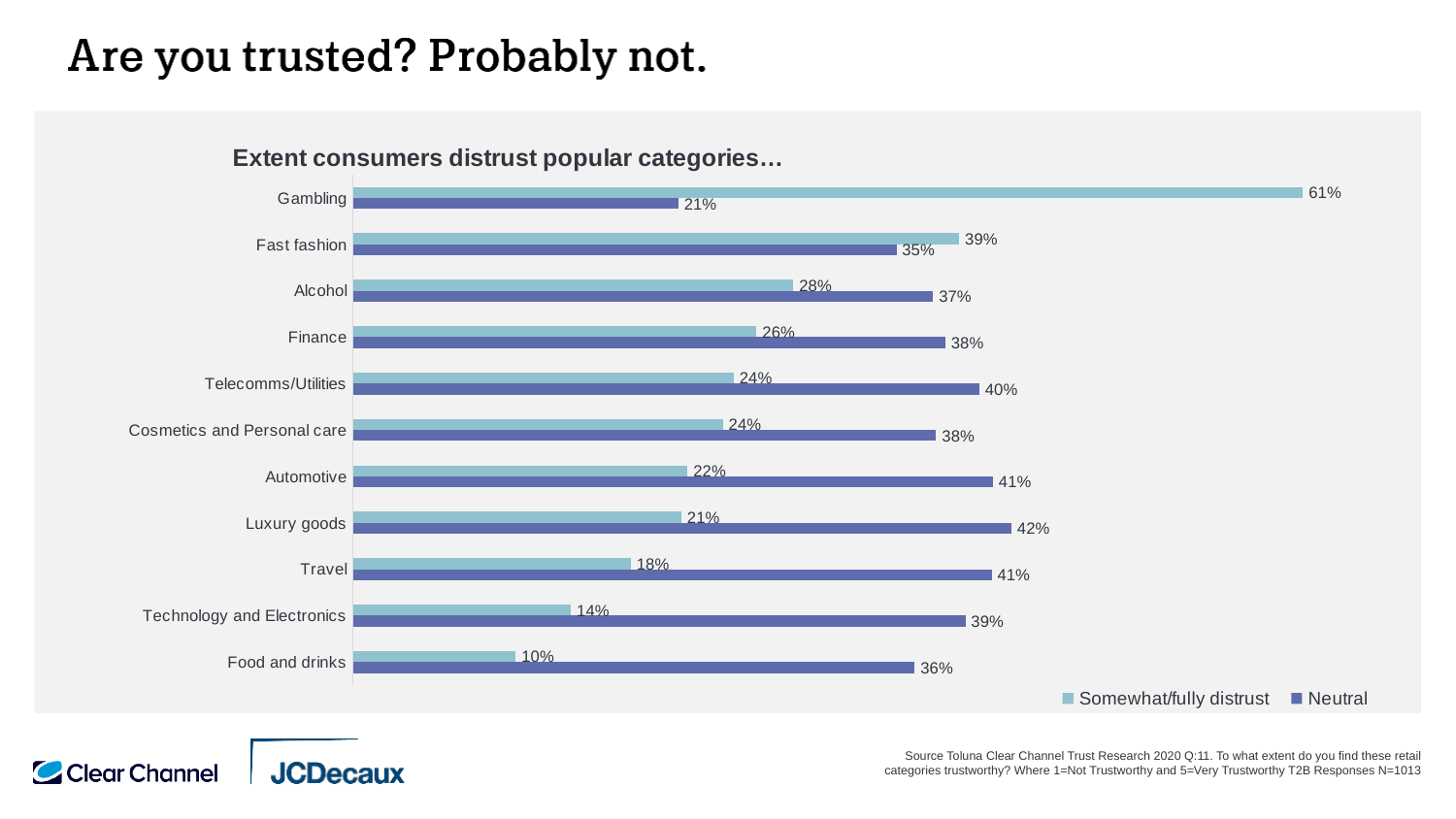
How many categories are shown in the chart? 11 What is the difference between the 'Somewhat/fully distrust' and 'Neutral' values for Gambling? 40% Which category has the lowest 'Neutral' value? Gambling What is the 'Somewhat/fully distrust' value for Food and drinks? 10% What is the title of the chart? Extent consumers distrust popular categories… What type of chart is shown on the slide? Bar chart What is the 'Somewhat/fully distrust' value for Gambling? 61% What is the 'Neutral' value for Luxury goods? 42% How many series does the legend list? 2 Which is larger for Alcohol: the 'Somewhat/fully distrust' value or the 'Neutral' value? Neutral Which category has the lowest 'Somewhat/fully distrust' value? Food and drinks Which category has the highest 'Somewhat/fully distrust' value? Gambling